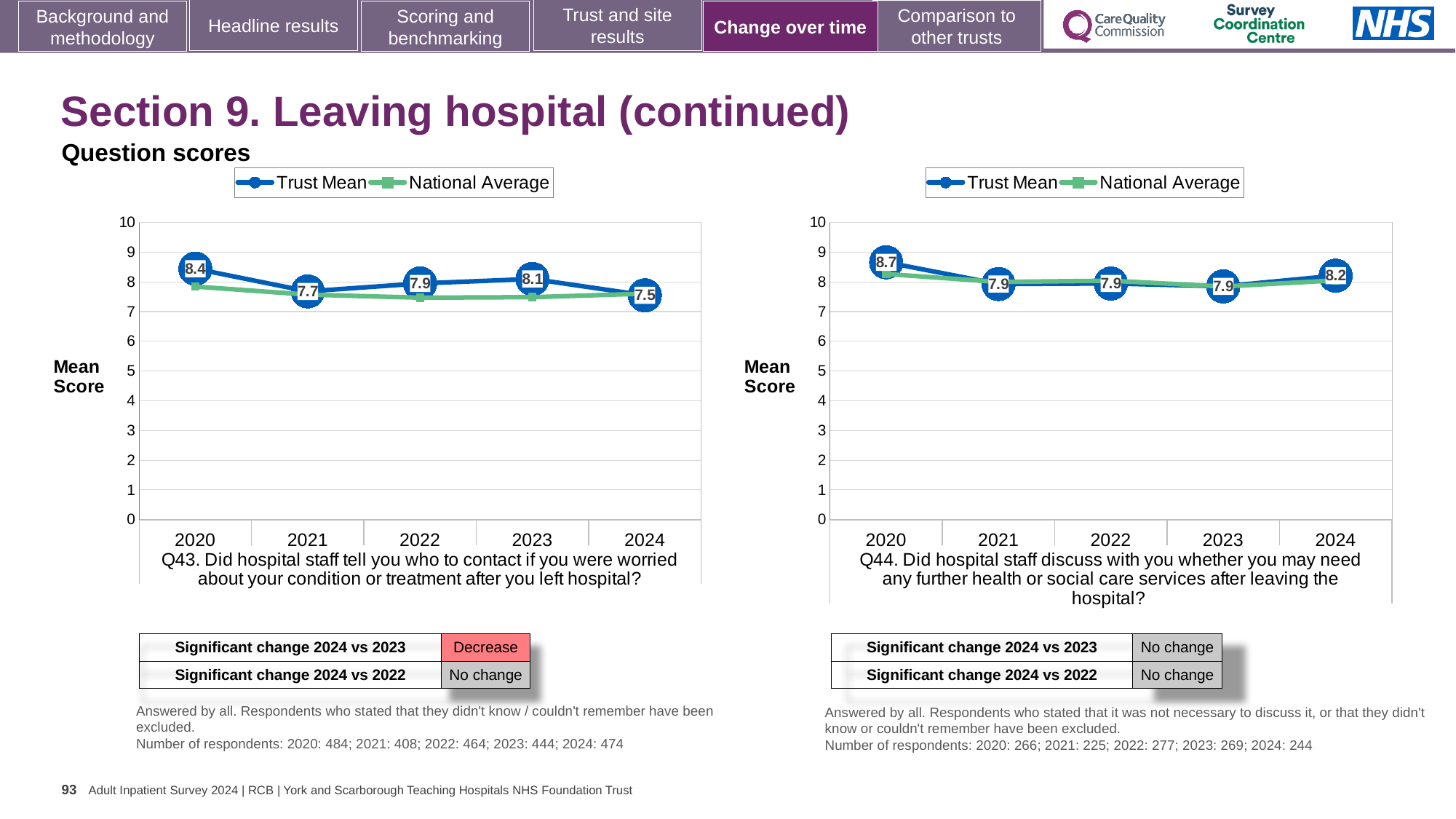
How many series does the legend of the Q44 chart (right) list? 2 In the Q43 chart (left), what is the Trust Mean score for 2024? 7.5 In the Q44 chart (right), is the Trust Mean score for 2020 greater or less than 8? greater In the Q43 chart (left), what is the difference between the Trust Mean scores for 2023 and 2024? 0.6 In the Q44 chart (right), what is the Trust Mean score for 2024? 8.2 In the Q43 chart (left), what is the Trust Mean score for 2020? 8.4 How many years are shown on the x axis of the Q43 chart (left)? 5 In the Q44 chart (right), which year has the highest Trust Mean score? 2020 In the Q44 chart (right), what is the Trust Mean score for 2020? 8.7 In the Q43 chart (left), which year has the lowest Trust Mean score? 2024 In the Q43 chart (left), which year has the highest Trust Mean score? 2020 What kind of chart is the Q43 chart (left)? Line chart